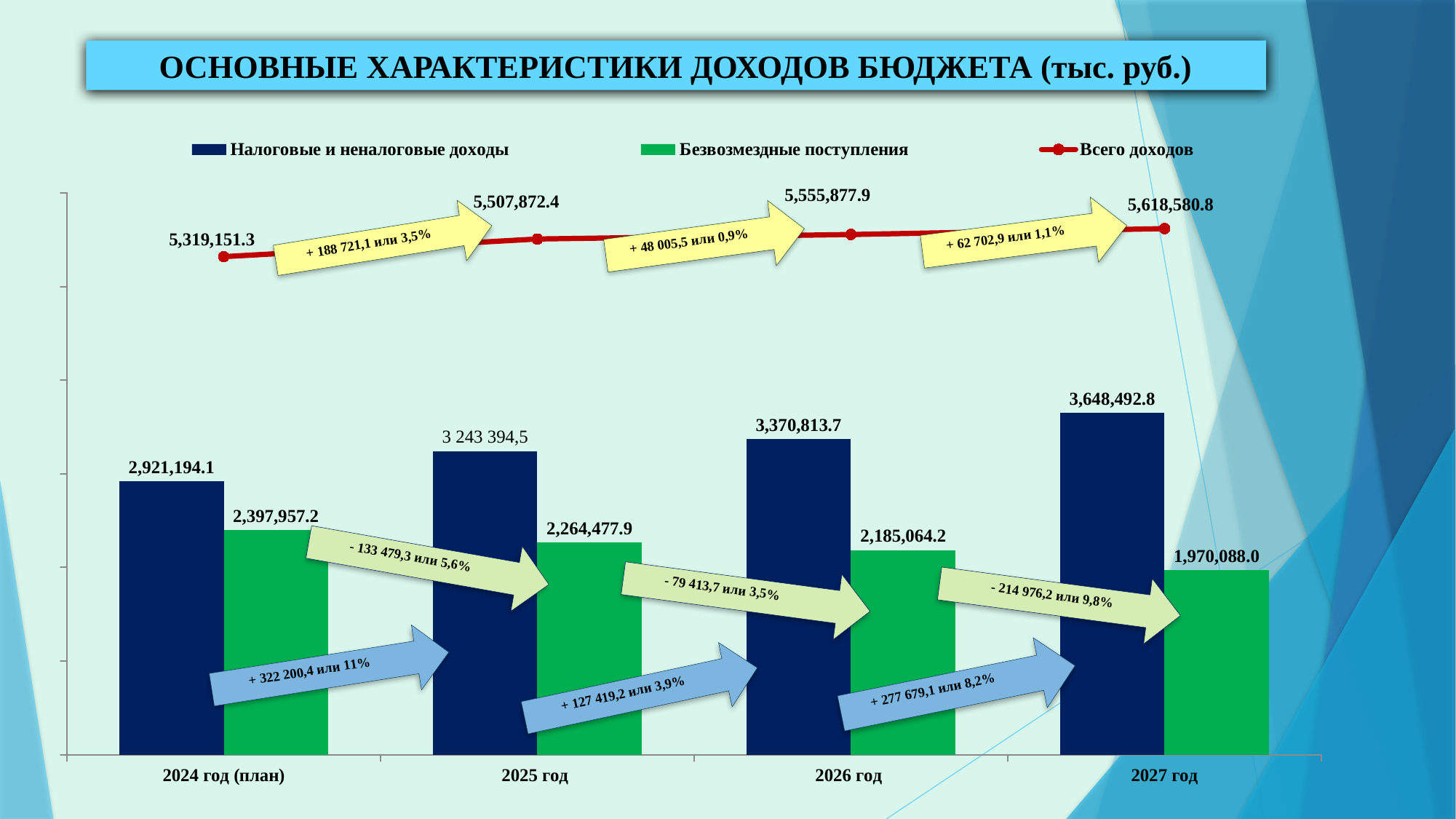
What colour represents Всего доходов in the legend? Red Do the values of Безвозмездные поступления rise or fall from 2024 год (план) to 2027 год? Fall In which year is Безвозмездные поступления lowest? 2027 год What is the value of Налоговые и неналоговые доходы for 2024 год (план)? 2,921,194.1 What is the value of Всего доходов for 2026 год? 5,555,877.9 How many series does the legend list? 3 What kind of chart is this? Combined bar and line chart In which year is Налоговые и неналоговые доходы highest? 2027 год How many years are shown on the x axis? 4 What is the value of Налоговые и неналоговые доходы for 2025 год? 3 243 394,5 Which is larger in 2026 год: Налоговые и неналоговые доходы or Безвозмездные поступления? Налоговые и неналоговые доходы What is the value of Безвозмездные поступления for 2027 год? 1,970,088.0